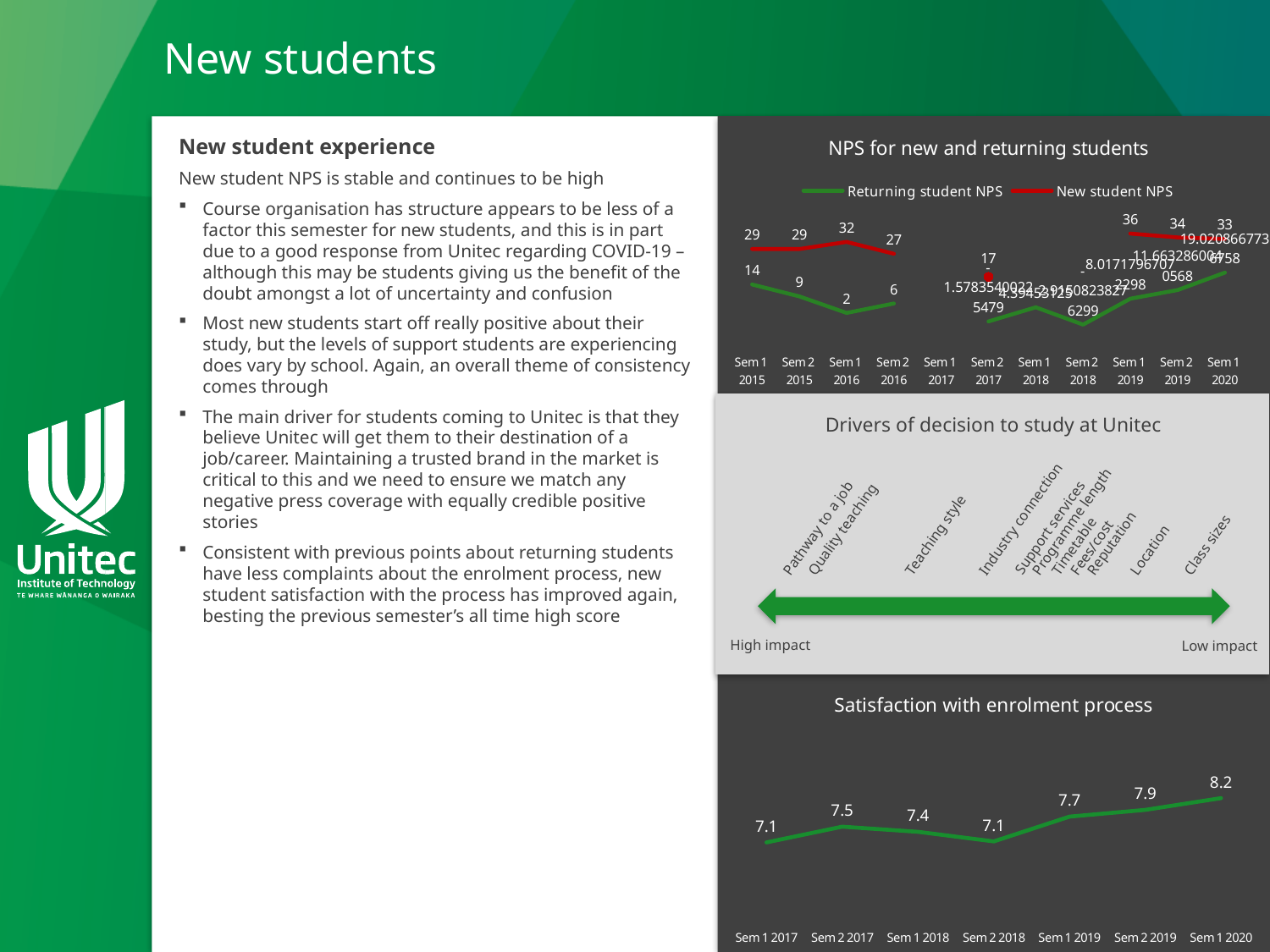
In the 'Drivers of decision to study at Unitec' chart, which driver is shown as having the highest impact? Pathway to a job In the 'Satisfaction with enrolment process' chart, how many semesters are plotted? 7 In the 'Satisfaction with enrolment process' chart, what is the difference between Sem 1 2020 and Sem 1 2017? 1.1 In the 'Satisfaction with enrolment process' chart, which semester has the highest value? Sem 1 2020 In the 'NPS for new and returning students' chart, what is the Returning student NPS for Sem 2 2015? 9 In the 'Satisfaction with enrolment process' chart, what is the value for Sem 1 2020? 8.2 In the 'Satisfaction with enrolment process' chart, what is the value for Sem 2 2017? 7.5 In the 'NPS for new and returning students' chart, what is the difference between the New student NPS and the Returning student NPS in Sem 1 2015? 15 What type of chart is 'Satisfaction with enrolment process'? line chart How many series does the legend of the 'NPS for new and returning students' chart list? 2 In the 'Satisfaction with enrolment process' chart, is the value for Sem 2 2019 larger or smaller than the value for Sem 1 2018? larger In the 'NPS for new and returning students' chart, what is the New student NPS for Sem 1 2016? 32